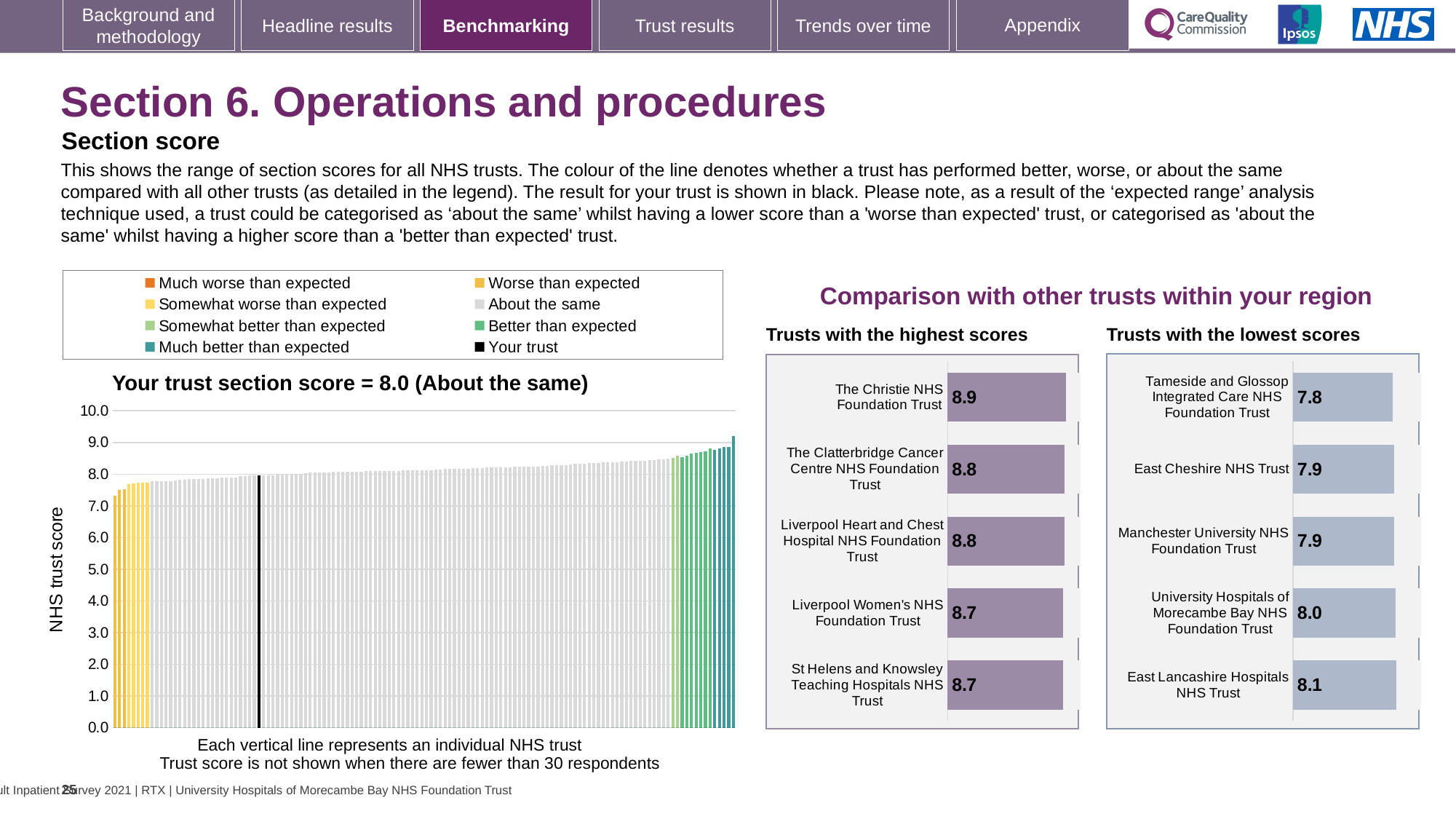
In the 'Trusts with the highest scores' chart, which trust has the highest score? The Christie NHS Foundation Trust In the 'Trusts with the lowest scores' chart, which trust has the lowest score? Tameside and Glossop Integrated Care NHS Foundation Trust How many entries does the legend above the 'Your trust section score' chart list? 8 In the 'Trusts with the highest scores' chart, what is the score for The Christie NHS Foundation Trust? 8.9 What kind of chart is the 'Your trust section score' chart on the left? Bar chart In the 'Trusts with the highest scores' chart, what is the difference between the scores of The Christie NHS Foundation Trust and St Helens and Knowsley Teaching Hospitals NHS Trust? 0.2 In the 'Trusts with the lowest scores' chart, what is the difference between the scores of East Lancashire Hospitals NHS Trust and Tameside and Glossop Integrated Care NHS Foundation Trust? 0.3 What is the section score for your trust shown in the 'Your trust section score' chart? 8.0 How many trusts are shown in the 'Trusts with the highest scores' chart? 5 In the 'Trusts with the lowest scores' chart, what is the score for East Lancashire Hospitals NHS Trust? 8.1 In the 'Trusts with the lowest scores' chart, what is the score for Tameside and Glossop Integrated Care NHS Foundation Trust? 7.8 In the 'Trusts with the lowest scores' chart, which has the higher score: East Cheshire NHS Trust or University Hospitals of Morecambe Bay NHS Foundation Trust? University Hospitals of Morecambe Bay NHS Foundation Trust